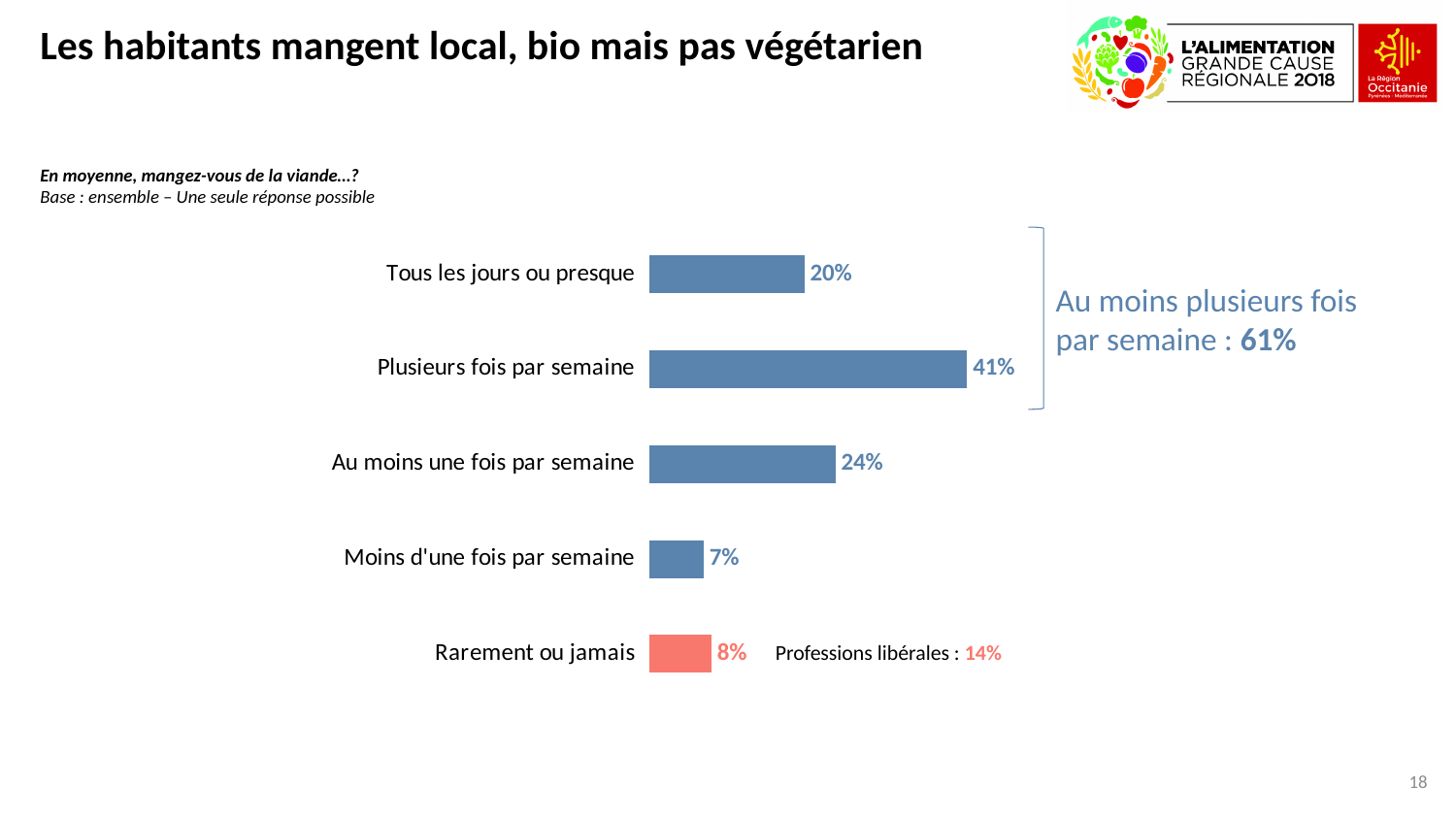
What is the value for "Tous les jours ou presque"? 20% Which is larger, "Tous les jours ou presque" or "Au moins une fois par semaine"? Au moins une fois par semaine Which category has the lowest value? Moins d'une fois par semaine What is the value for "Plusieurs fois par semaine"? 41% What is the difference between "Plusieurs fois par semaine" and "Au moins une fois par semaine"? 17% Which category has the highest value? Plusieurs fois par semaine What is the value for "Moins d'une fois par semaine"? 7% How many categories are shown in the chart? 5 Which category's bar is coloured differently (red) from the others? Rarement ou jamais What kind of chart is shown on the slide? Bar chart What is the value for "Rarement ou jamais"? 8% What is the combined share for "Au moins plusieurs fois par semaine" as annotated on the slide? 61%